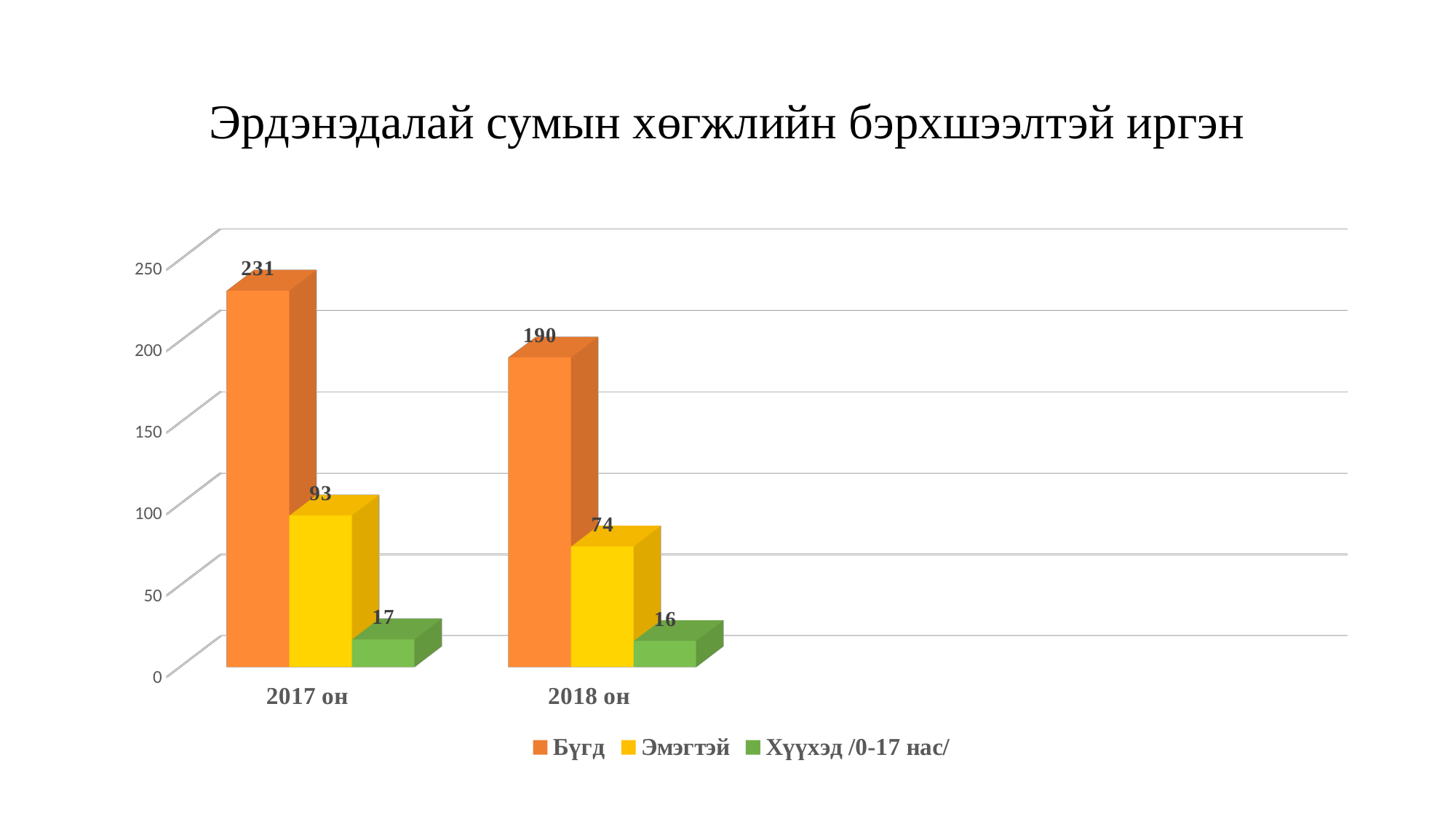
Which series has the lowest value in 2018 он? Хүүхэд /0-17 нас/ What is the value for Бүгд in 2017 он? 231 Which year has the higher value for Бүгд? 2017 он What is the difference between the Эмэгтэй values for 2017 он and 2018 он? 19 How many series does the legend list? 3 What kind of chart is shown on the slide? Bar chart What is the difference between the Бүгд values for 2017 он and 2018 он? 41 Does the value for Хүүхэд /0-17 нас/ rise or fall from 2017 он to 2018 он? Fall What is the value for Хүүхэд /0-17 нас/ in 2017 он? 17 What is the value for Эмэгтэй in 2018 он? 74 Is the value for Эмэгтэй in 2017 он larger than the value for Эмэгтэй in 2018 он? Yes What is the value for Бүгд in 2018 он? 190